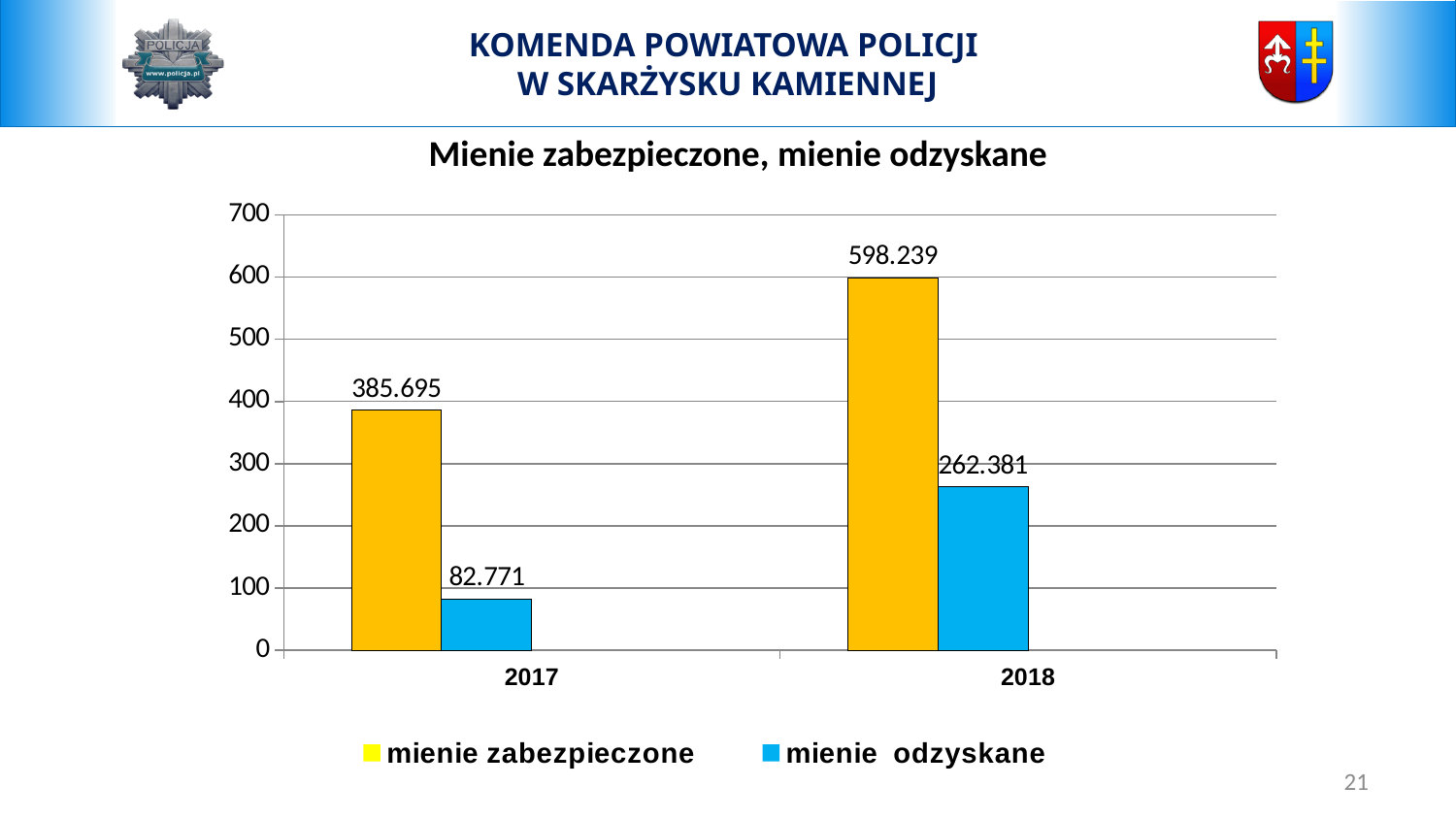
What is the difference between mienie zabezpieczone in 2018 and in 2017? 212.544 What kind of chart is shown on the slide? bar chart What is the title of the chart? Mienie zabezpieczone, mienie odzyskane What is the value of mienie zabezpieczone for 2018? 598.239 Is mienie odzyskane in 2018 larger or smaller than mienie zabezpieczone in 2017? smaller What is the value of mienie odzyskane for 2018? 262.381 Which bar in the chart has the lowest value? mienie odzyskane in 2017 What is the difference between mienie zabezpieczone and mienie odzyskane in 2017? 302.924 What is the value of mienie odzyskane for 2017? 82.771 How many series does the legend list? 2 Which year has the higher value for mienie zabezpieczone? 2018 What is the value of mienie zabezpieczone for 2017? 385.695